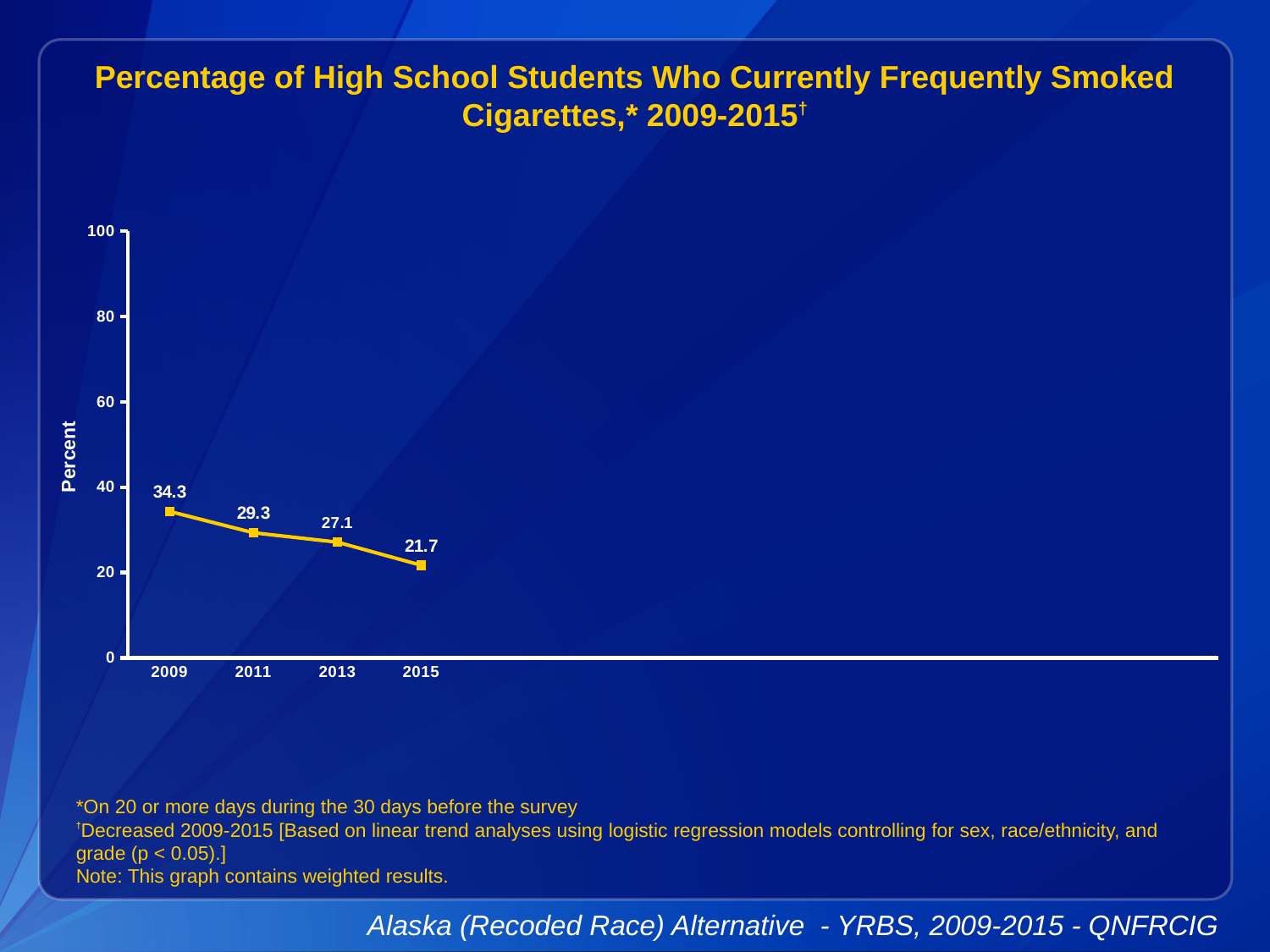
What is the label on the y axis? Percent What was the percentage of high school students who currently frequently smoked cigarettes in 2009? 34.3 Is the value for 2011 greater or less than 40? less What was the percentage of high school students who currently frequently smoked cigarettes in 2015? 21.7 What value is plotted for 2013? 27.1 Which year has the highest percentage? 2009 Which is larger, the value for 2011 or the value for 2013? 2011 What is the difference between the 2009 value and the 2015 value? 12.6 Which year has the lowest percentage? 2015 How many years are plotted on the chart? 4 Do the values rise or fall from 2009 to 2015? fall What kind of chart is shown on the slide? line chart